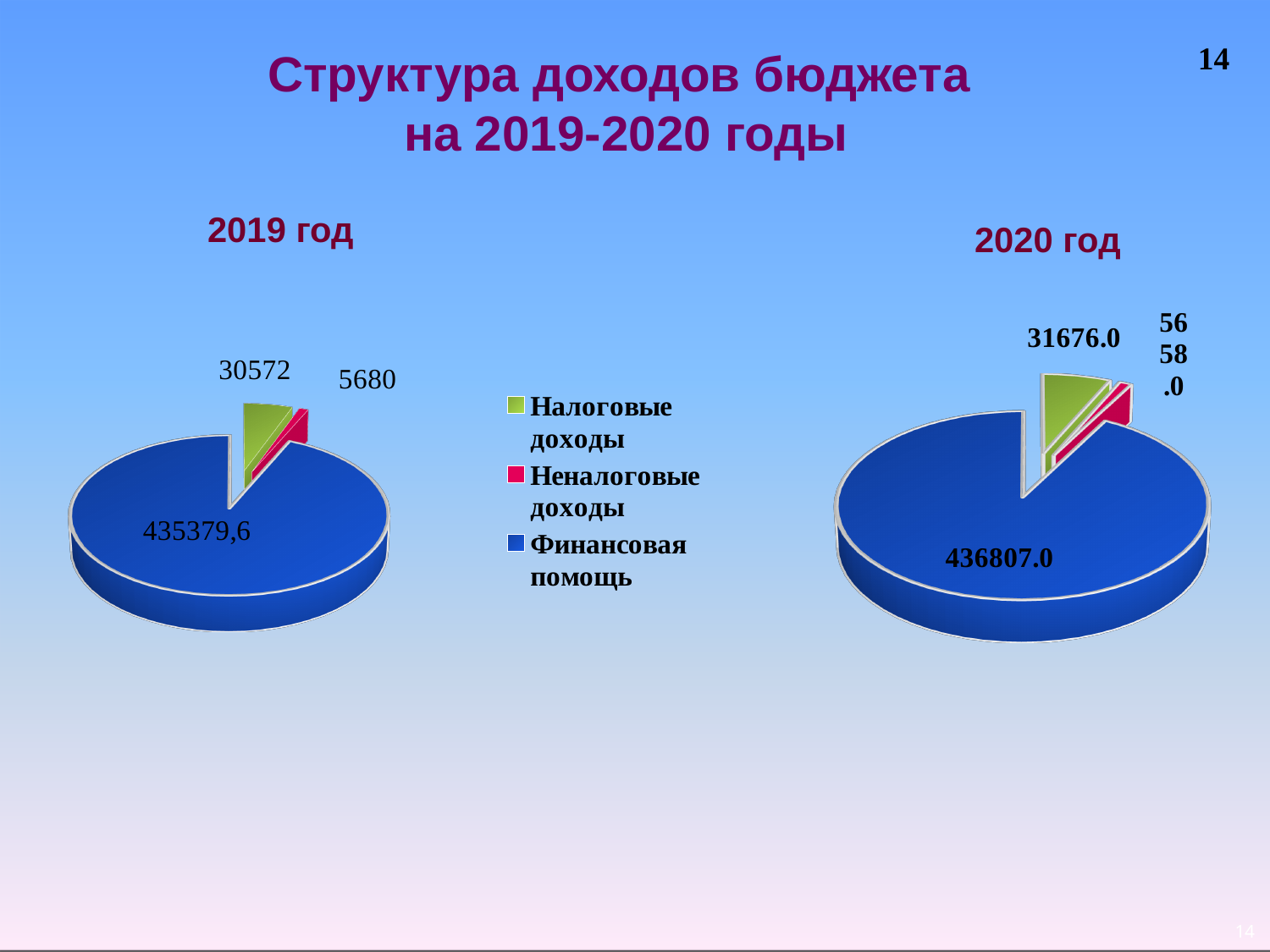
In the 2019 год chart, what is the value for Неналоговые доходы? 5680 In the 2019 год chart, which category has the largest slice? Финансовая помощь In the 2019 год chart, what is the difference between Налоговые доходы and Неналоговые доходы? 24892 Which is larger: Налоговые доходы in the 2019 год chart or Налоговые доходы in the 2020 год chart? 2020 год In the 2019 год chart, what is the value for Налоговые доходы? 30572 How many series does the legend list? 3 Which colour represents Финансовая помощь in the legend? Blue In the 2020 год chart, what is the value for Налоговые доходы? 31676.0 In the 2019 год chart, what is the value for Финансовая помощь? 435379,6 In the 2020 год chart, which category has the smallest slice? Неналоговые доходы In the 2020 год chart, what is the value for Финансовая помощь? 436807.0 What type of charts are shown on the slide? Pie charts